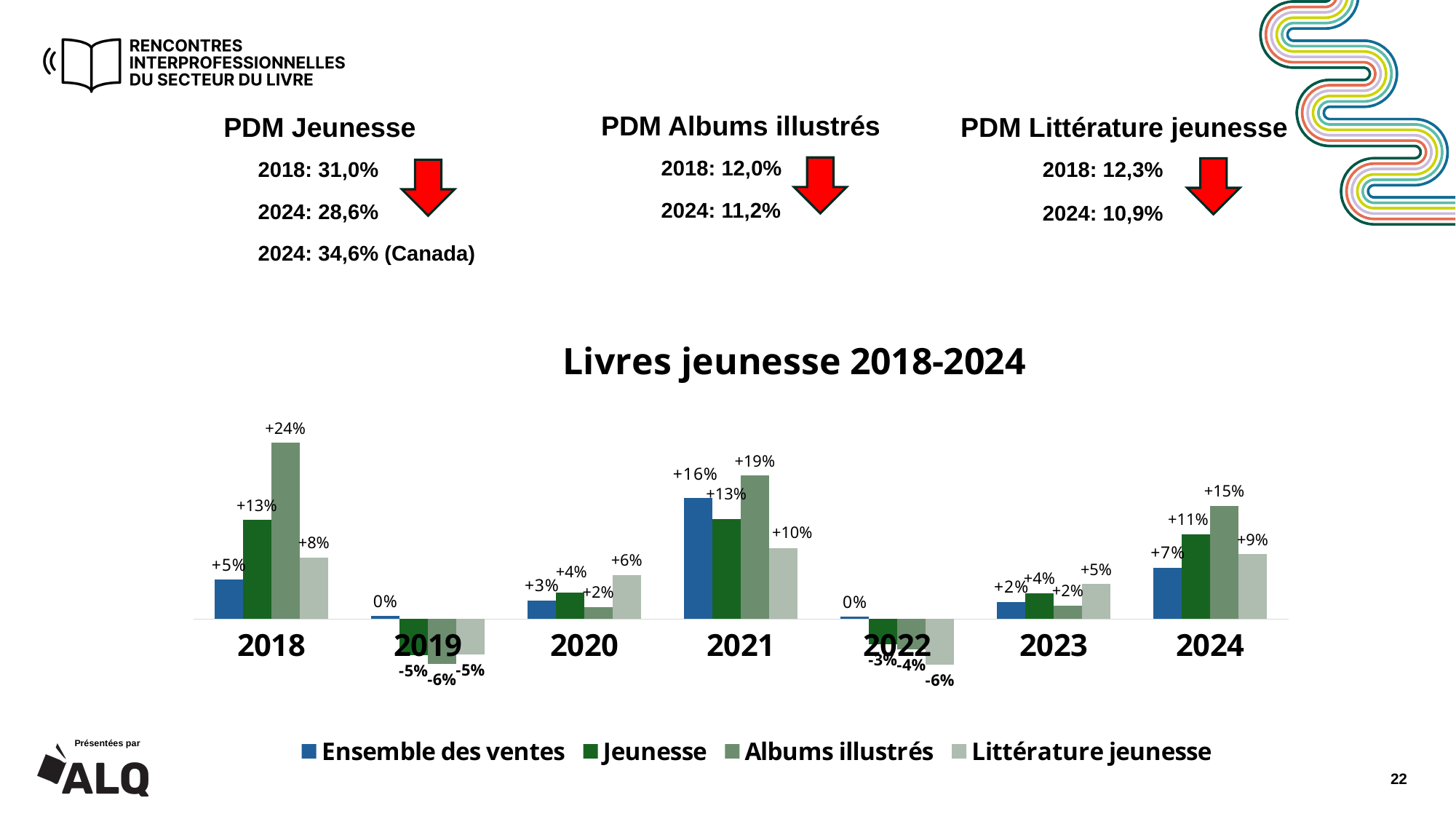
What is the difference between the Albums illustrés value and the Ensemble des ventes value in 2024? 8 percentage points What is the value for Jeunesse in 2024? +11% In which year is the Jeunesse value lowest? 2019 What type of chart is shown on the slide? bar chart What is the title of the chart? Livres jeunesse 2018-2024 Which is larger in 2020: the Littérature jeunesse value or the Jeunesse value? Littérature jeunesse What is the value for Albums illustrés in 2018? +24% What is the value for Ensemble des ventes in 2021? +16% In which year is the Albums illustrés value highest? 2018 How many series does the chart legend list? 4 What is the value for Littérature jeunesse in 2022? -6% How many years are shown on the x axis of the chart? 7